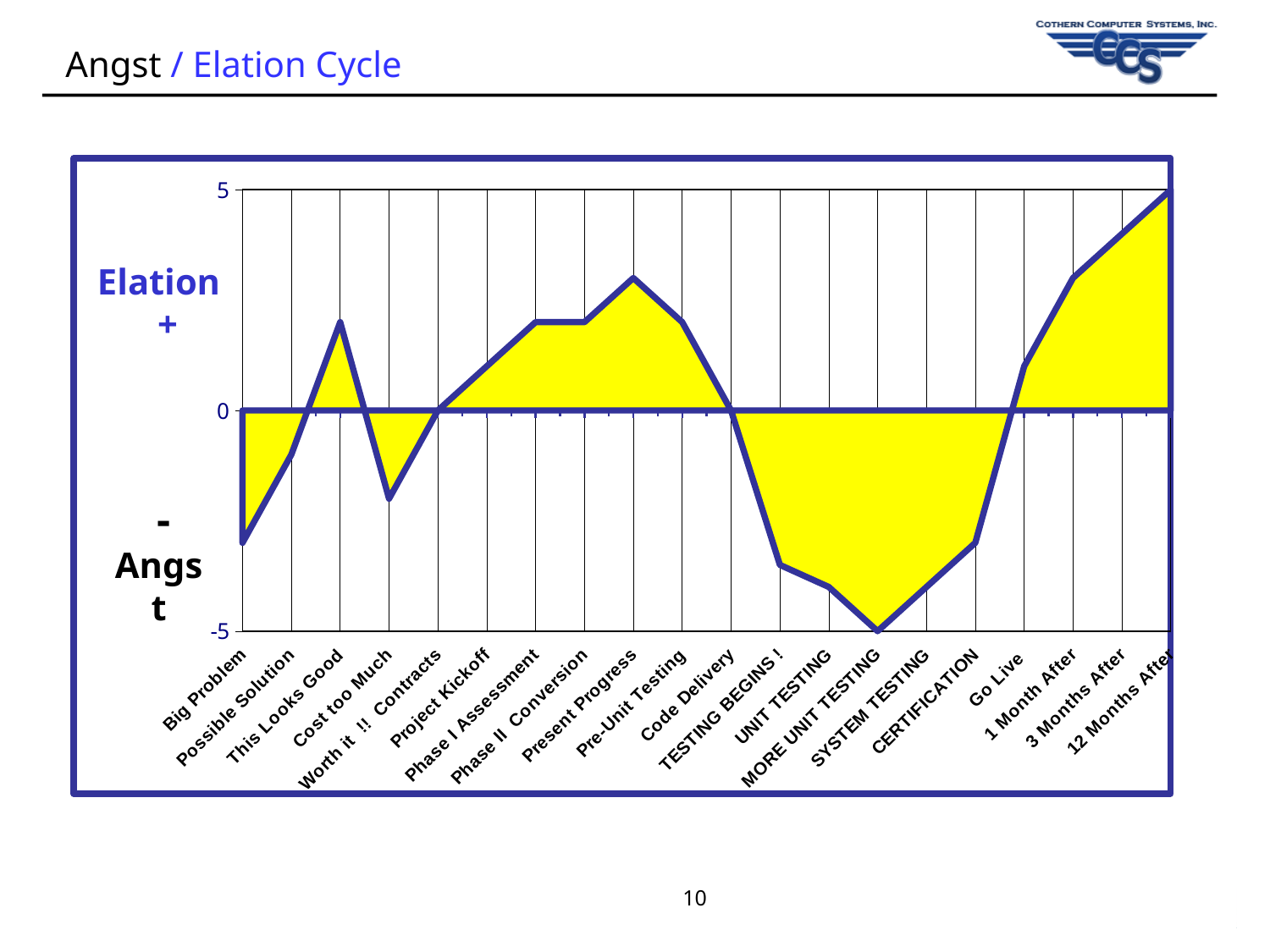
Is the value for UNIT TESTING greater or less than 0? less What is the value for 12 Months After? 5 What is the value for MORE UNIT TESTING? -5 Which is larger, the value for This Looks Good or the value for Cost too Much? This Looks Good Which category has the highest value on the chart? 12 Months After Which category has the lowest value on the chart? MORE UNIT TESTING What kind of chart is shown on the slide? Area chart Is the value for Present Progress greater or less than 0? greater Is the value for Big Problem greater or less than 0? less How many categories are shown along the x axis? 20 What is the value for Code Delivery? 0 Do the values rise or fall from MORE UNIT TESTING to 12 Months After? Rise